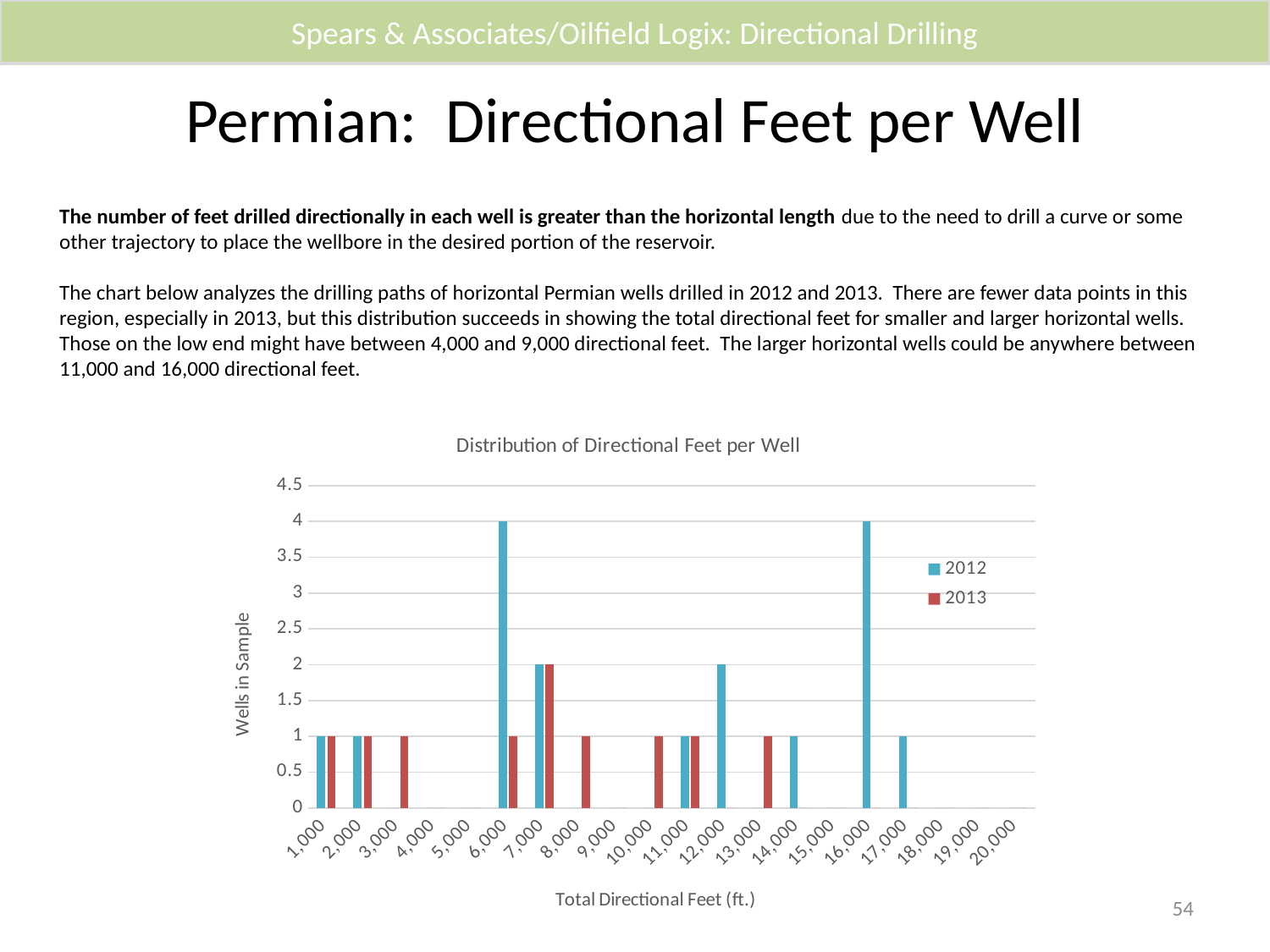
What is the highest value reached by the 2013 series? 2 How many wells in the 2012 series fall in the 12,000 category? 2 How many series does the chart legend list? 2 What is the title of the chart? Distribution of Directional Feet per Well How many wells in the 2012 series fall in the 6,000 category? 4 How many wells in the 2013 series fall in the 7,000 category? 2 Is the 2012 value at the 16,000 category greater or less than 3? greater Which is larger at the 6,000 category: the 2012 value or the 2013 value? 2012 How many categories are shown along the x axis of the chart? 20 What kind of chart is shown on the slide? bar chart What is the label of the y axis? Wells in Sample What is the difference between the 2012 value and the 2013 value at the 6,000 category? 3